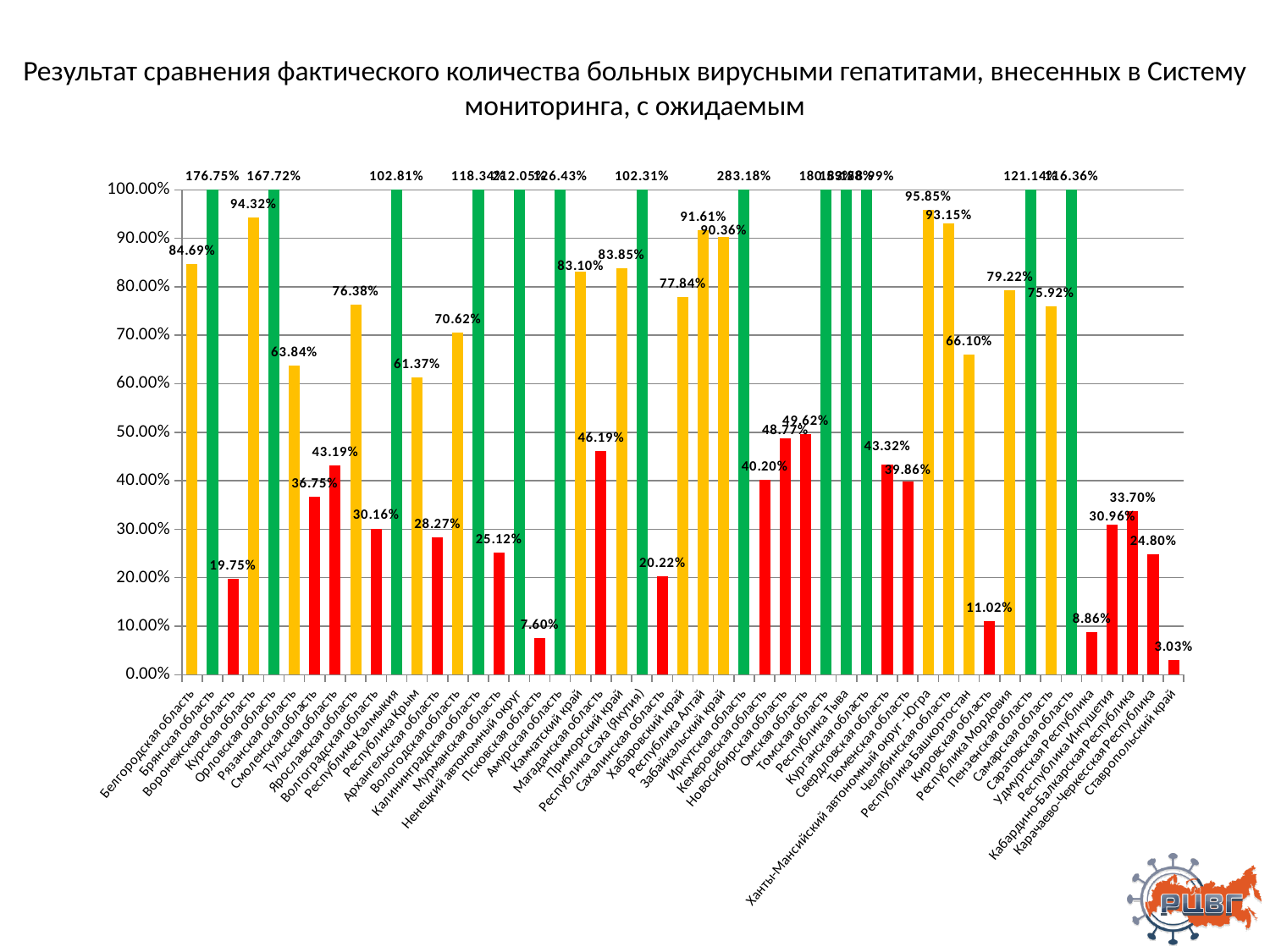
How many different bar colours are used in the chart? 3 What is the value shown for Ставропольский край? 3.03% What is the difference between the values for Брянская область and Белгородская область? 92.06% What is the difference between the values for Кабардино-Балкарская Республика and Карачаево-Черкесская Республика? 8.90% Is the value for Ставропольский край greater or less than 10.00%? less What is the highest value labelled on the chart? 283.18% What is the value shown for Белгородская область? 84.69% Which is larger, the value for Белгородская область or the value for Ставропольский край? Белгородская область Which region has the lowest value on the chart? Ставропольский край What kind of chart is shown on the slide? Bar chart What is the value shown for Брянская область? 176.75% What is the value shown for Воронежская область? 19.75%